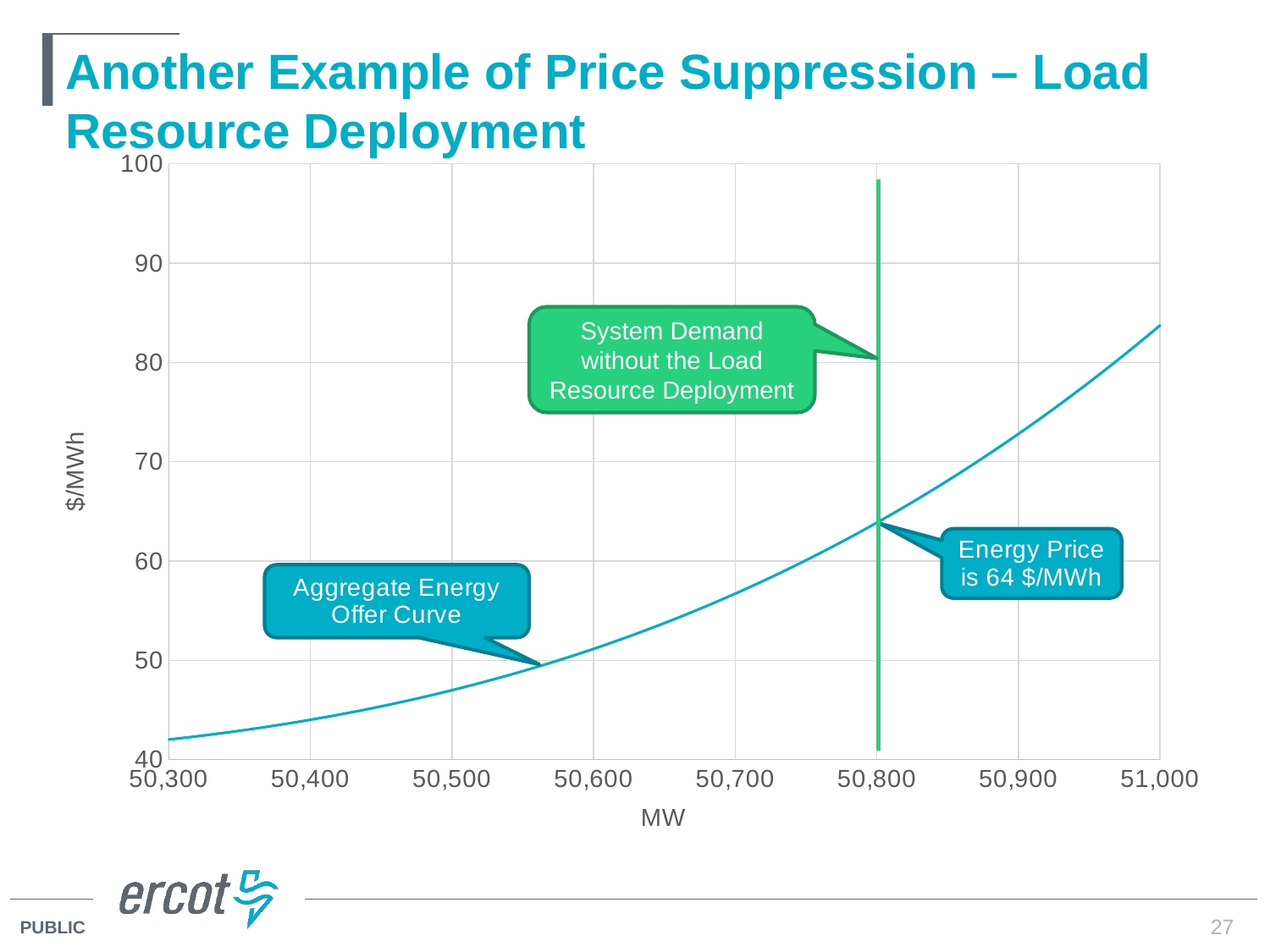
According to the callout, what is the energy price where the offer curve meets the system demand line? 64 $/MWh What kind of chart is shown on the slide? line chart Is the value of the Aggregate Energy Offer Curve at 50,300 MW greater or less than 50? less Is the value of the Aggregate Energy Offer Curve at 51,000 MW greater or less than 80? greater What is the label of the x axis? MW Is the value of the Aggregate Energy Offer Curve at 50,600 MW greater or less than 60? less What is the label of the y axis? $/MWh Which is larger, the offer curve value at 50,900 MW or at 50,500 MW? 50,900 MW Does the Aggregate Energy Offer Curve rise or fall as MW increases along the x axis? rises How many tick labels are shown on the x axis? 8 At what MW value is the vertical 'System Demand without the Load Resource Deployment' line drawn? 50,800